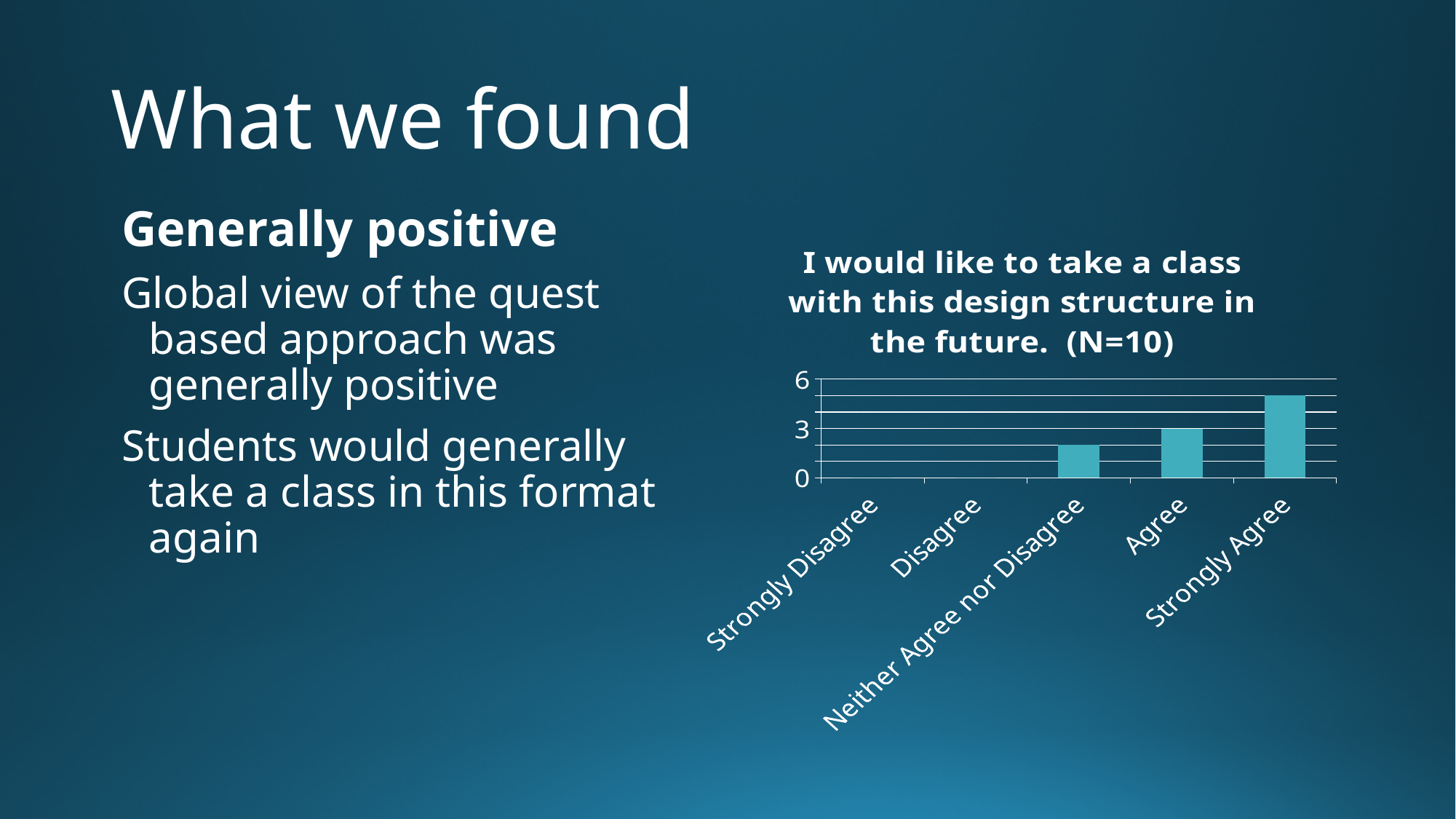
How many response categories are shown on the x axis of the chart? 5 What kind of chart is shown on the slide? bar chart Do the values rise or fall moving from Neither Agree nor Disagree to Strongly Agree along the x axis? rise Is the value for Strongly Agree greater or less than 3? greater Which is larger, the value for Strongly Agree or the value for Agree? Strongly Agree Which category has the highest value? Strongly Agree What sample size (N) is stated in the chart title? N=10 What is the title of the chart? I would like to take a class with this design structure in the future. (N=10) Is the value for Neither Agree nor Disagree greater or less than 3? less Is the value for Strongly Disagree greater or less than 3? less What is the value for Agree? 3 Which is larger, the value for Agree or the value for Neither Agree nor Disagree? Agree